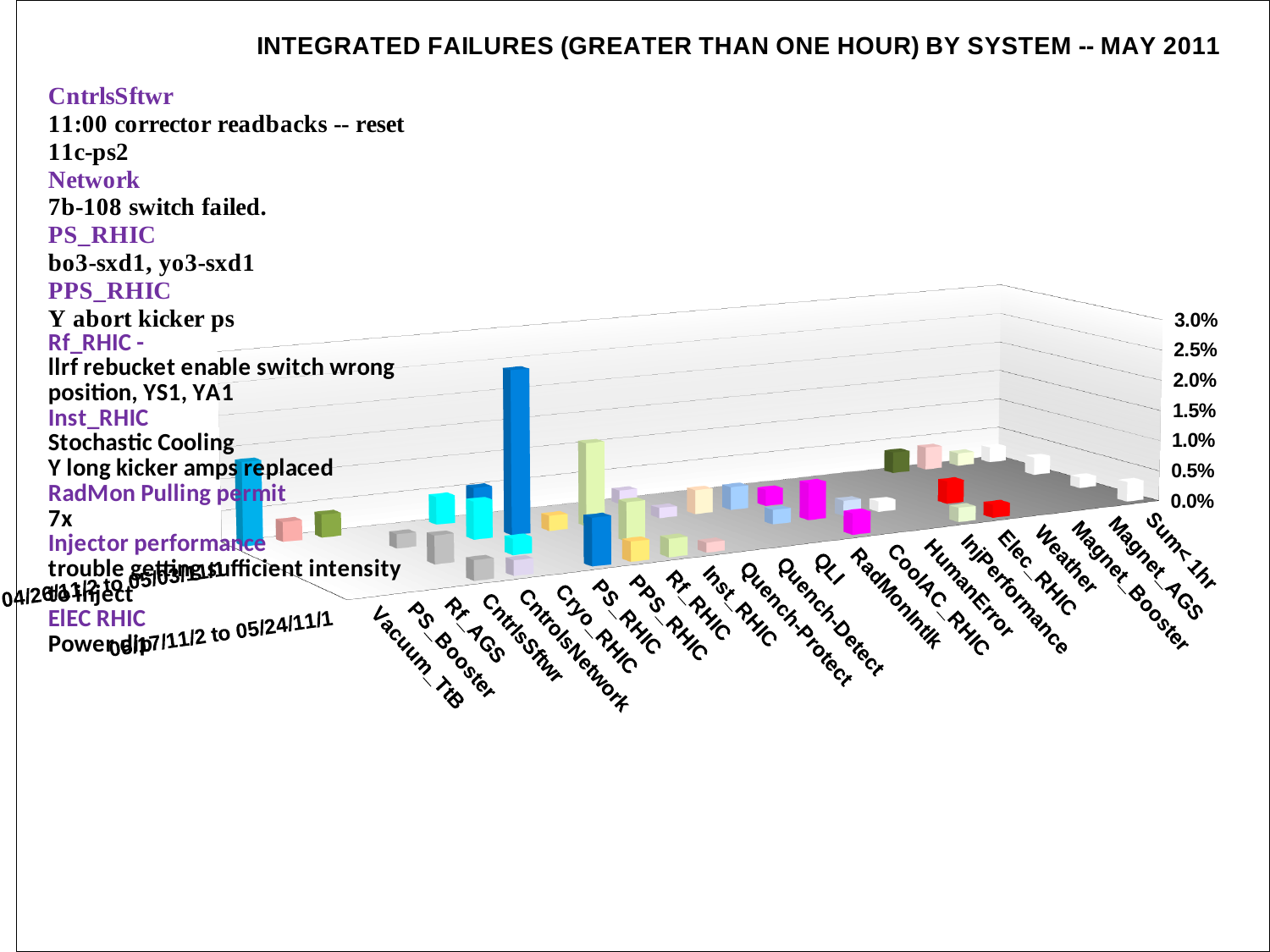
What is the title of the chart? INTEGRATED FAILURES (GREATER THAN ONE HOUR) BY SYSTEM -- MAY 2011 Are the bars for Weather greater or less than 0.5%? less What kind of chart is shown on the slide? bar chart What is the last category on the x axis of the chart? Sum<1hr What is the first category on the x axis of the chart? Vacuum_TtB How many system categories are listed along the x axis of the chart? 22 What is the highest value shown on the vertical axis of the chart? 3.0% Is the tallest bar for CntrlsSftwr greater or less than 1.0%? less Which system category has the tallest bar in the chart? PS_RHIC Which has a taller bar, CntrlsSftwr or Vacuum_TtB? Vacuum_TtB